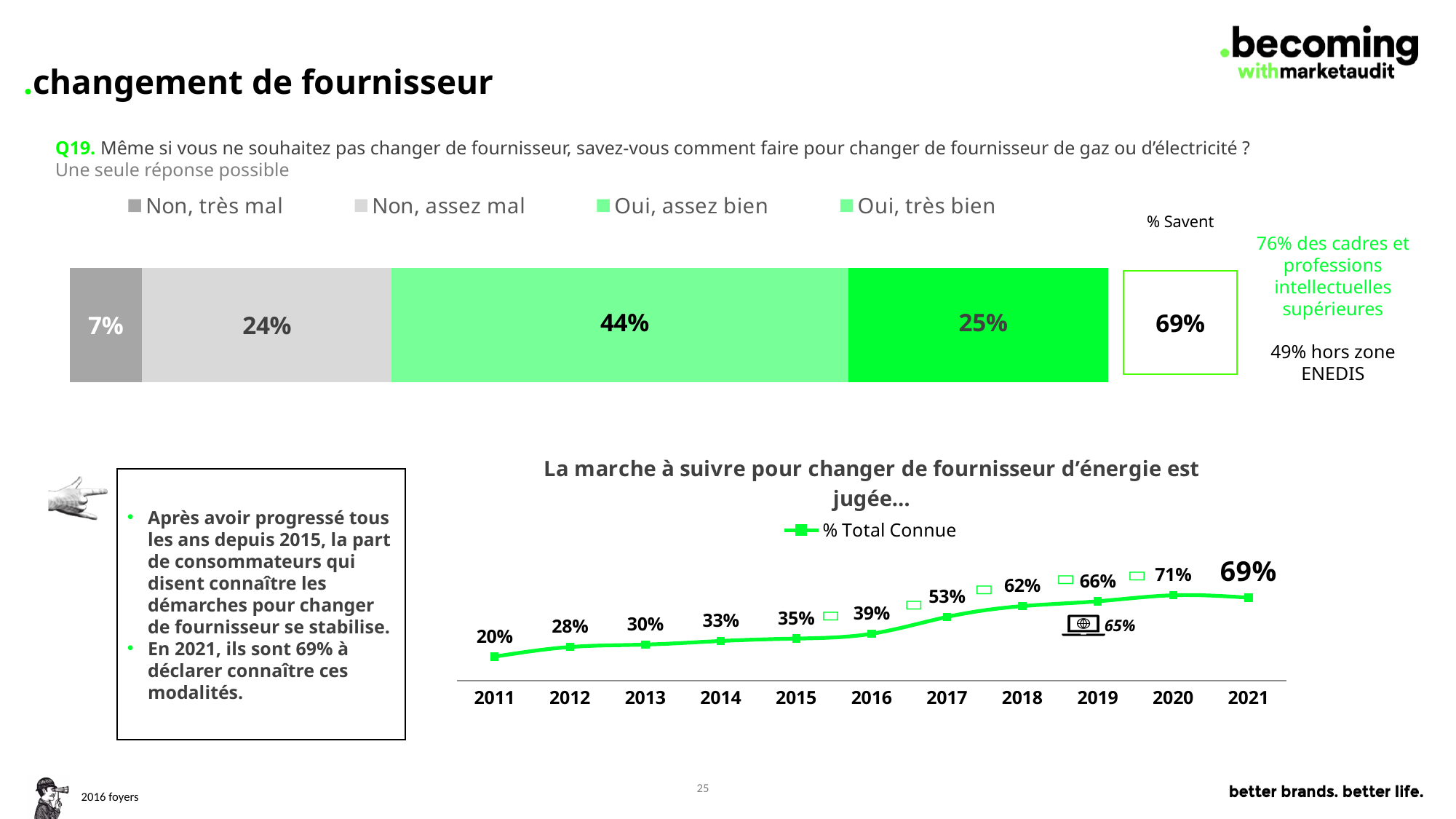
In the line chart "La marche à suivre pour changer de fournisseur d'énergie est jugée…", what is the difference between the 2021 value and the 2016 value? 30% In the line chart "La marche à suivre pour changer de fournisseur d'énergie est jugée…", what is the value for 2017? 53% In the top stacked bar chart, which category has the largest segment? Oui, assez bien In the line chart "La marche à suivre pour changer de fournisseur d'énergie est jugée…", how many years are plotted on the x axis? 11 In the top stacked bar chart, what is the difference between "Non, assez mal" and "Non, très mal"? 17% In the top stacked bar chart, what is the combined total of "Oui, assez bien" and "Oui, très bien"? 69% In the line chart "La marche à suivre pour changer de fournisseur d'énergie est jugée…", what is the value for 2011? 20% In the top stacked bar chart, what is the value for "Non, très mal"? 7% In the top stacked bar chart, how many series does the legend list? 4 In the top stacked bar chart, what is the value for "Oui, assez bien"? 44% In the line chart "La marche à suivre pour changer de fournisseur d'énergie est jugée…", which year has the highest value? 2020 In the line chart "La marche à suivre pour changer de fournisseur d'énergie est jugée…", what is the name of the series shown in the legend? % Total Connue